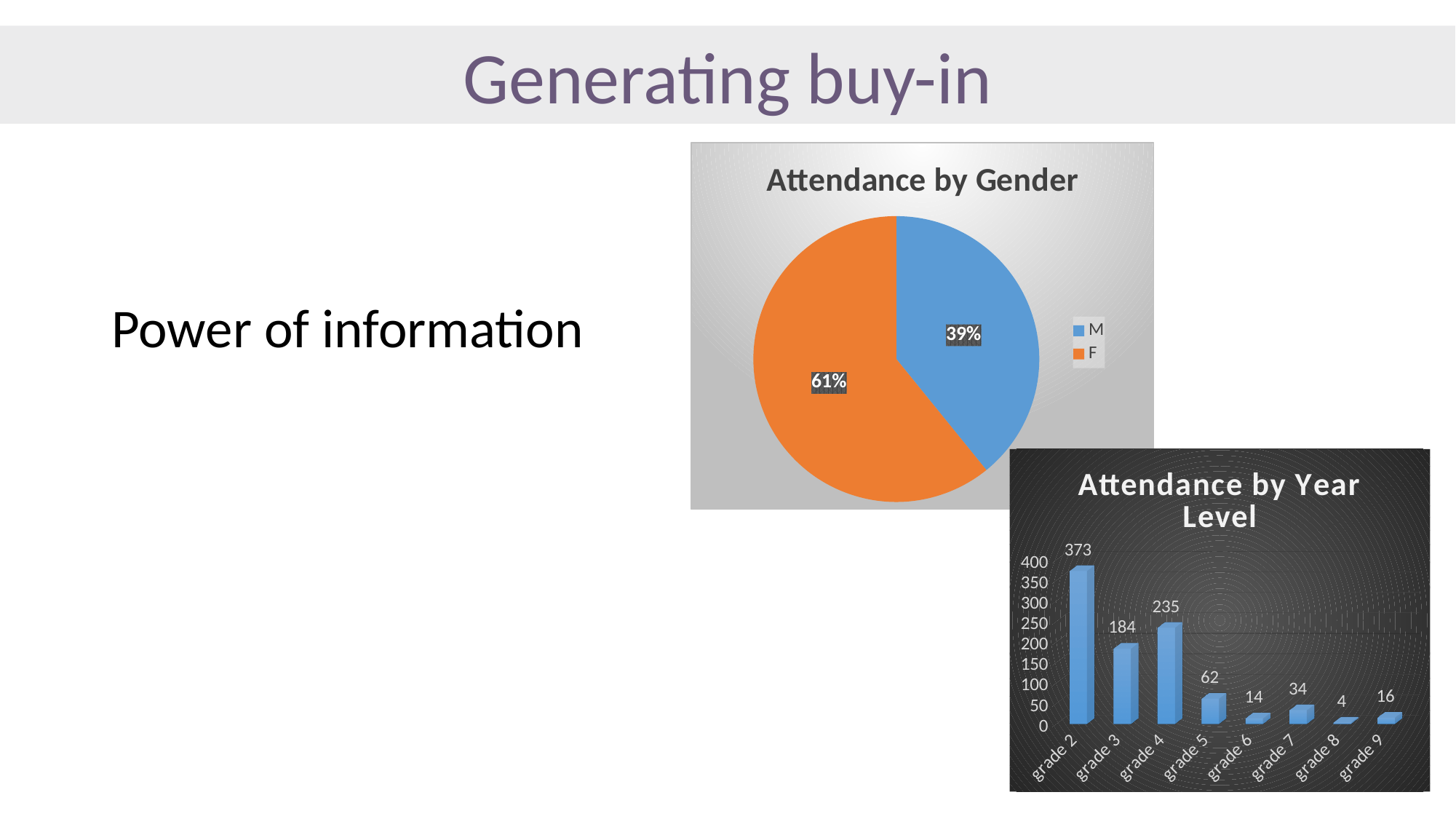
In the 'Attendance by Year Level' chart, which grade has the lowest attendance? grade 8 In the 'Attendance by Gender' chart, what share of attendance is F? 61% In the 'Attendance by Gender' chart, which category has the larger share, M or F? F In the 'Attendance by Year Level' chart, what is the value for grade 7? 34 What kind of chart is 'Attendance by Gender'? Pie chart How many grade categories are shown in the 'Attendance by Year Level' chart? 8 In the 'Attendance by Gender' chart, what share of attendance is M? 39% How many entries does the legend of the 'Attendance by Gender' chart list? 2 In the 'Attendance by Year Level' chart, what is the value for grade 4? 235 What kind of chart is 'Attendance by Year Level'? Bar chart In the 'Attendance by Year Level' chart, what is the difference between grade 2 and grade 3? 189 In the 'Attendance by Year Level' chart, which grade has the highest attendance? grade 2